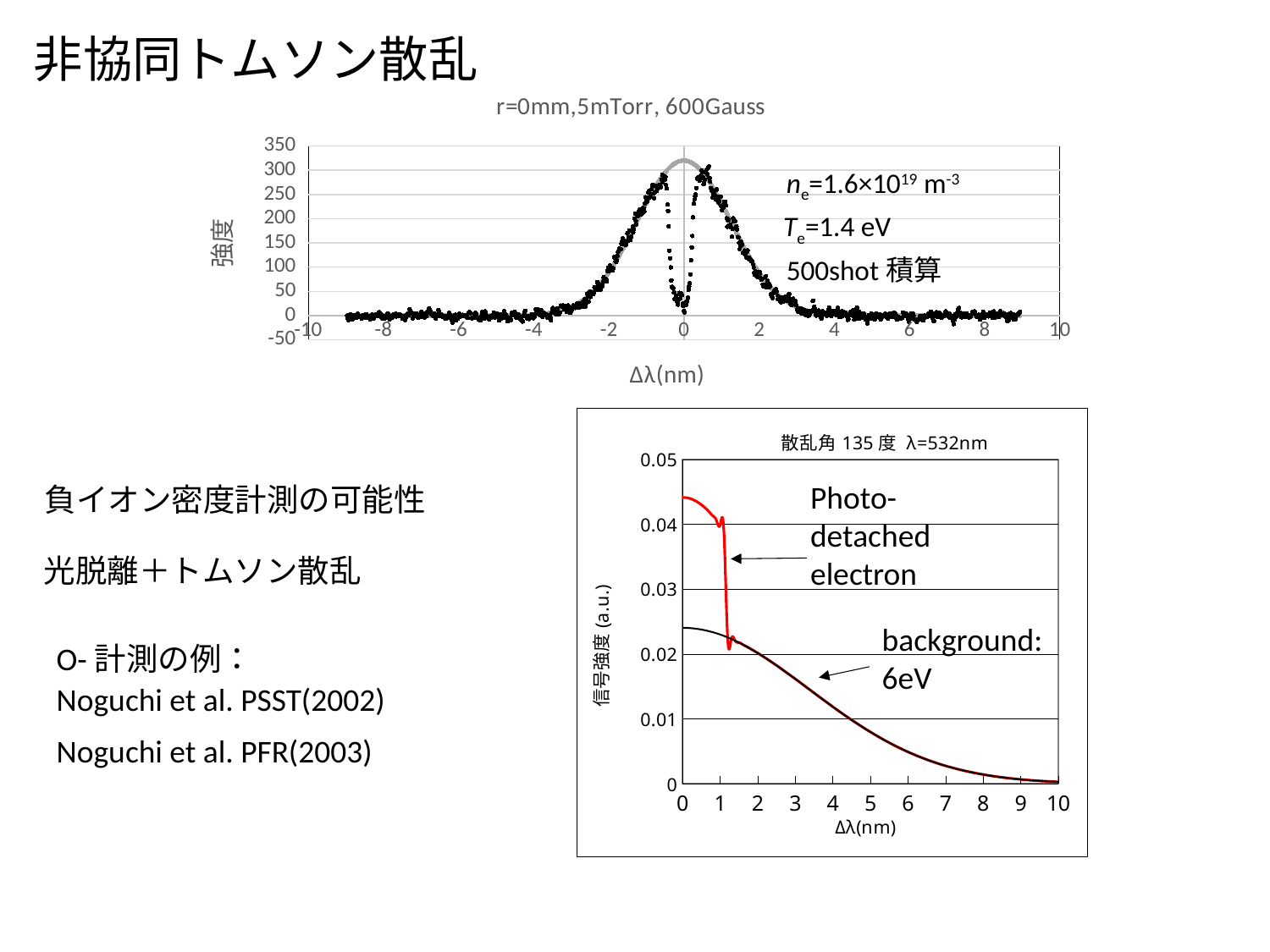
In the bottom chart (散乱角 135 度 λ=532nm), is the value of the background curve at Δλ=0 greater or less than 0.02? greater In the top chart (r=0mm,5mTorr, 600Gauss), is the value at Δλ=4 greater or less than 100? less In the top chart (r=0mm,5mTorr, 600Gauss), is the value at Δλ=-1 greater or less than 200? greater What is the title of the top chart? r=0mm,5mTorr, 600Gauss In the bottom chart (散乱角 135 度 λ=532nm), do the values rise or fall as Δλ increases from 2 to 10? fall In the bottom chart (散乱角 135 度 λ=532nm), which is larger at Δλ=0: the red curve or the background curve? the red curve What is the title of the bottom chart? 散乱角 135 度 λ=532nm What kind of chart is the bottom chart (散乱角 135 度 λ=532nm)? line chart